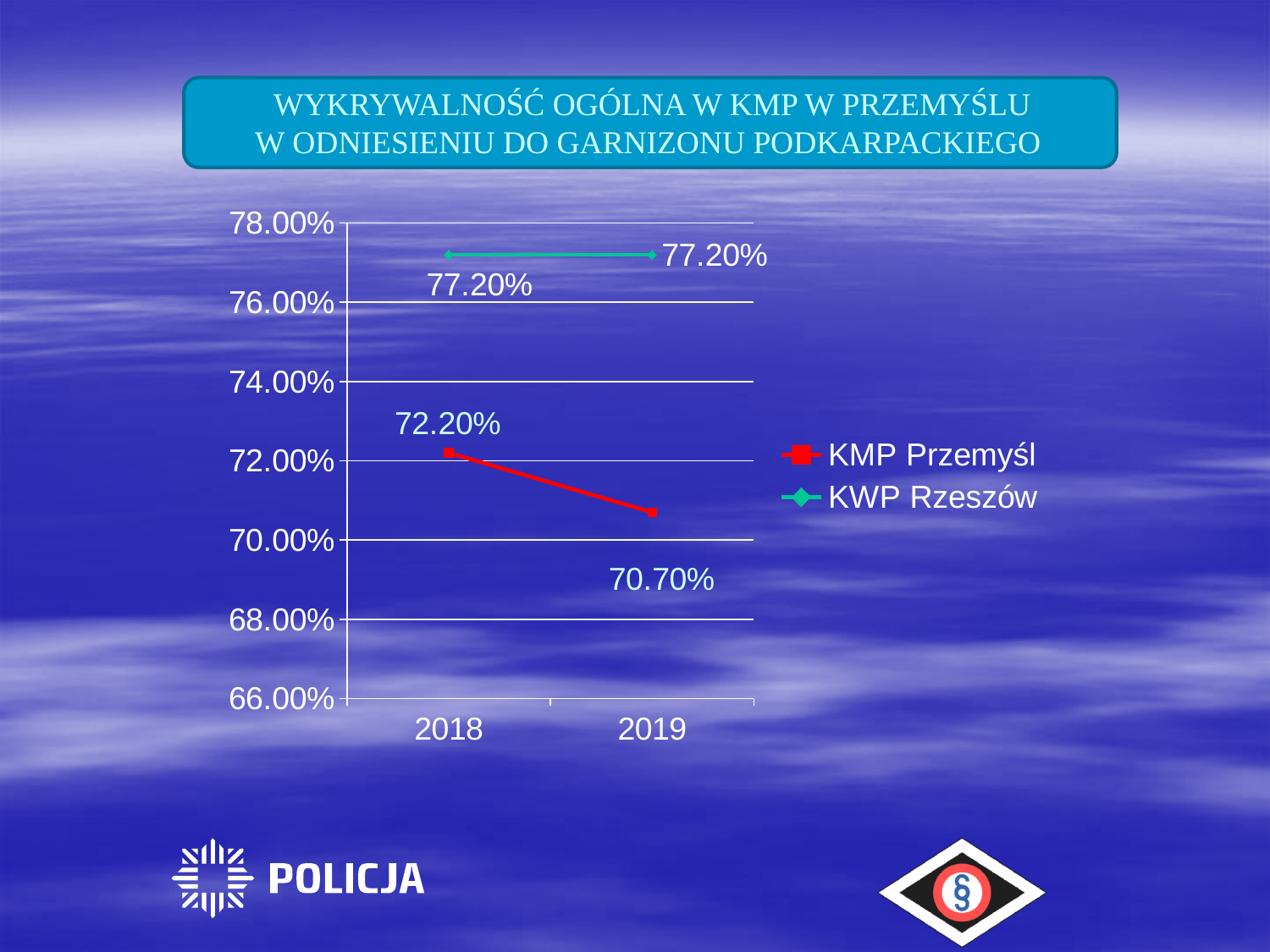
What is the value for KMP Przemyśl in 2018? 72.20% How many series does the legend list? 2 What kind of chart is shown on the slide? line chart What is the value for KWP Rzeszów in 2018? 77.20% Does the value for KMP Przemyśl rise or fall from 2018 to 2019? fall What is the value for KMP Przemyśl in 2019? 70.70% How many years are shown on the x axis? 2 What is the difference between the KMP Przemyśl values for 2018 and 2019? 1.50% What colour is the line for KMP Przemyśl? red What is the value for KWP Rzeszów in 2019? 77.20% What is the difference between KWP Rzeszów and KMP Przemyśl in 2019? 6.50% Which series has the higher value in 2018, KMP Przemyśl or KWP Rzeszów? KWP Rzeszów